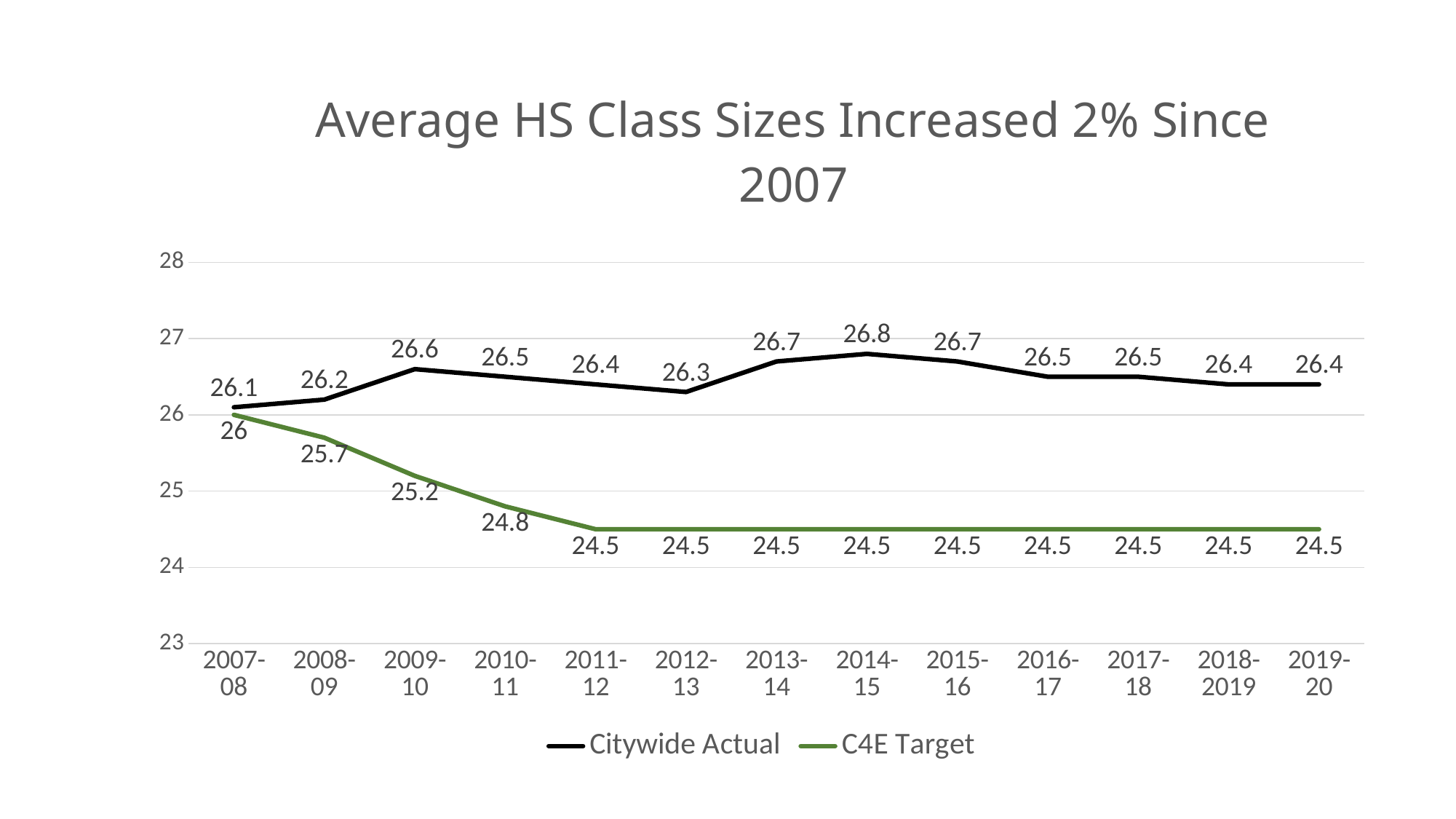
What is the title of the chart? Average HS Class Sizes Increased 2% Since 2007 How many series does the legend list? 2 In which year is the Citywide Actual value lowest? 2007-08 Which is larger in 2010-11, the Citywide Actual value or the C4E Target value? Citywide Actual Does the C4E Target series rise or fall from 2007-08 to 2011-12? Fall In which year is the Citywide Actual value highest? 2014-15 What is the Citywide Actual value for 2007-08? 26.1 What is the C4E Target value for 2008-09? 25.7 How many school years are shown on the x axis? 13 What is the difference between the Citywide Actual and C4E Target values in 2019-20? 1.9 What is the Citywide Actual value for 2014-15? 26.8 What kind of chart is shown on the slide? Line chart